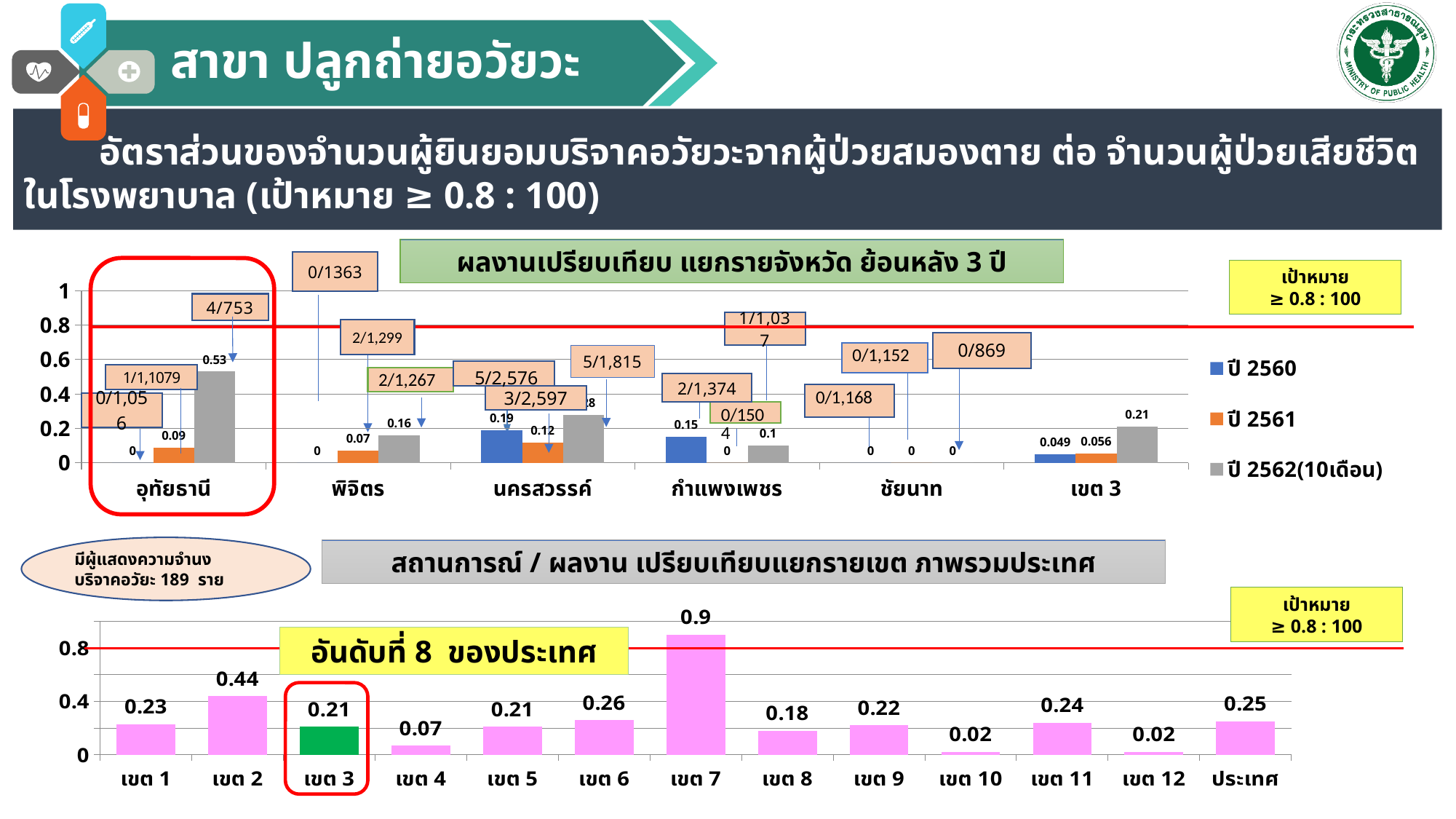
In the top chart, what is the value for กำแพงเพชร in the ปี 2560 series? 0.15 In the top chart, what is the value for อุทัยธานี in the ปี 2562(10เดือน) series? 0.53 In the bottom chart, what is the difference between the values for เขต 2 and เขต 3? 0.23 In the bottom chart, how many bars are plotted? 13 What kind of chart is the bottom chart? bar chart In the top chart, what is the value for เขต 3 in the ปี 2561 series? 0.056 In the bottom chart, which is larger, the value for เขต 1 or the value for เขต 6? เขต 6 In the bottom chart, what is the value for ประเทศ? 0.25 In the bottom chart (สถานการณ์ / ผลงาน เปรียบเทียบแยกรายเขต ภาพรวมประเทศ), what is the value for เขต 7? 0.9 In the bottom chart, which category has the highest value? เขต 7 In the top chart (ผลงานเปรียบเทียบ แยกรายจังหวัด ย้อนหลัง 3 ปี), how many series does the legend list? 3 In the bottom chart, is the value for เขต 2 greater or less than 0.8? less